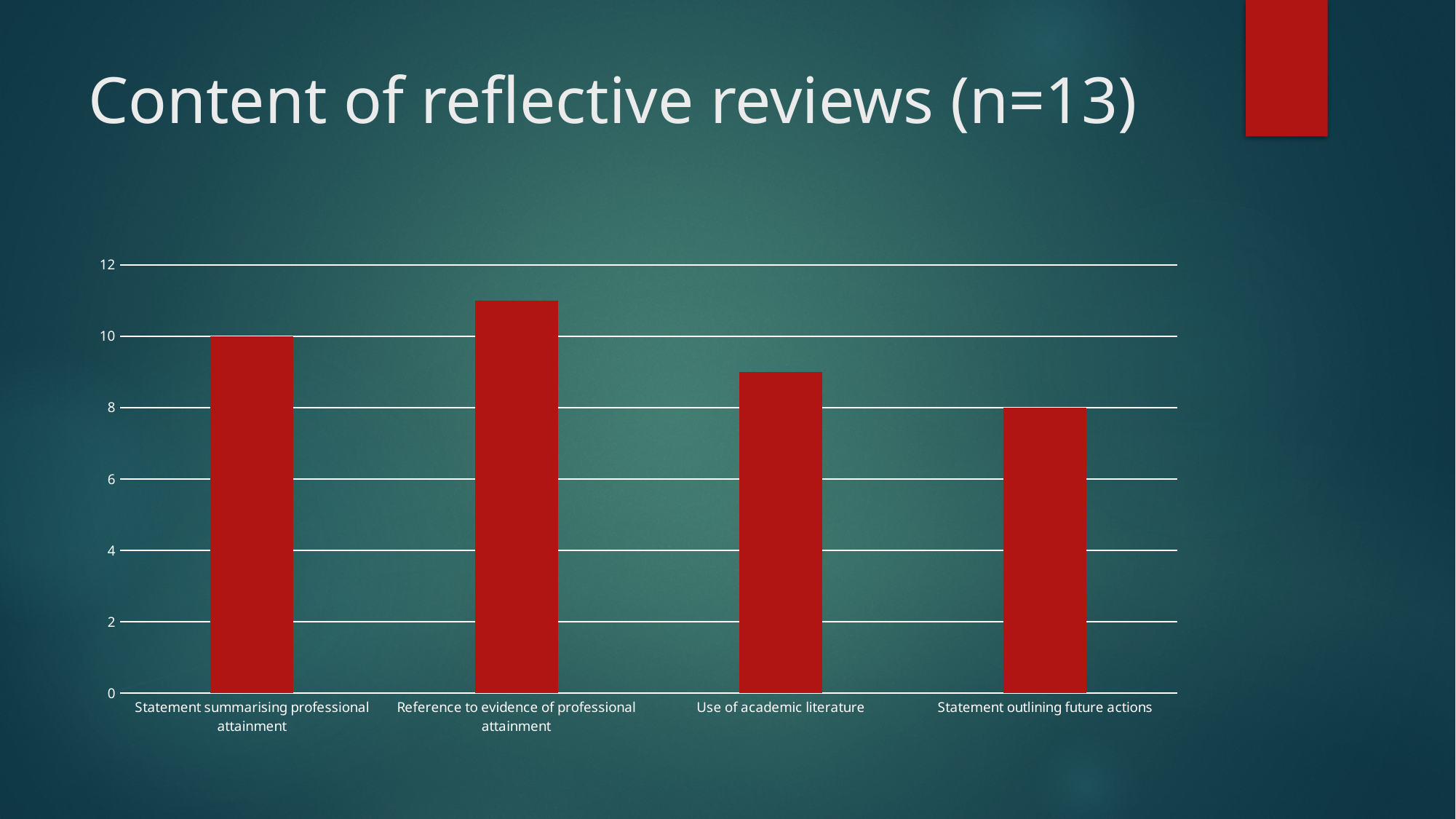
Which category has the highest value? Reference to evidence of professional attainment What is the difference between the values for 'Statement summarising professional attainment' and 'Statement outlining future actions'? 2 How many categories are plotted in the chart? 4 What is the title of the chart on the slide? Content of reflective reviews (n=13) Is the value for 'Reference to evidence of professional attainment' greater or less than 10? greater What colour are the bars in the chart? Red What is the value for 'Statement outlining future actions'? 8 What type of chart is shown on the slide? Bar chart Which category has the lowest value? Statement outlining future actions What is the value for 'Statement summarising professional attainment'? 10 Which is larger, the value for 'Use of academic literature' or the value for 'Statement outlining future actions'? Use of academic literature Is the value for 'Use of academic literature' greater or less than 10? less